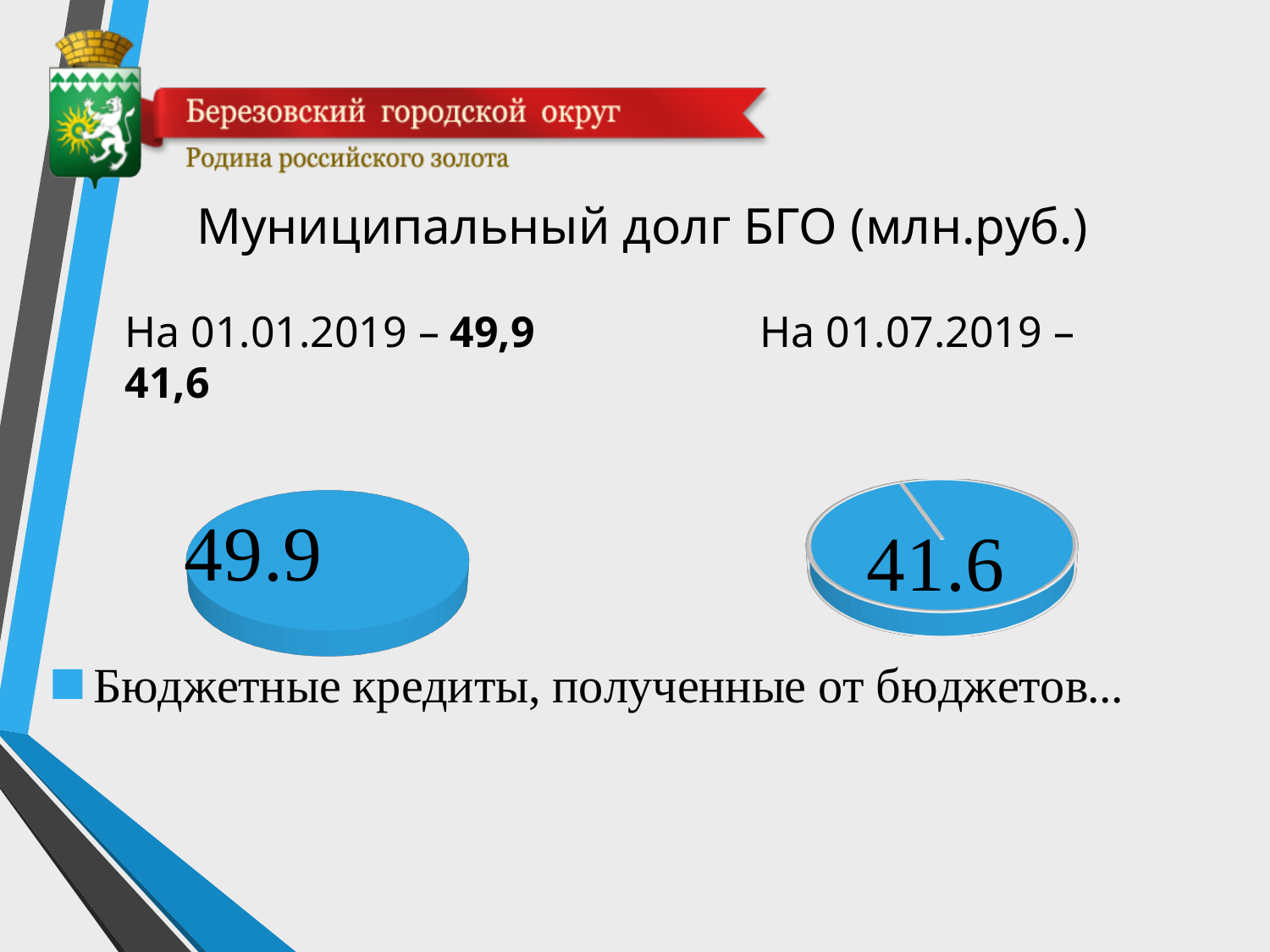
How many pie charts are on the slide? 2 Is the value on the left pie chart greater or less than 45? greater What is the difference between the value on the left pie chart (49.9) and the value on the right pie chart (41.6)? 8.3 What value is shown on the left pie chart? 49.9 What kind of charts are shown on the slide? Pie charts What legend entry is shown below the pie charts? Бюджетные кредиты, полученные от бюджетов... Does the municipal debt rise or fall from 01.01.2019 to 01.07.2019? Fall What is the title of the slide above the charts? Муниципальный долг БГО (млн.руб.) Is the value on the right pie chart greater or less than 45? less Which pie chart shows the larger value, the left one or the right one? The left one How many entries does the legend list? 1 What value is shown on the right pie chart? 41.6